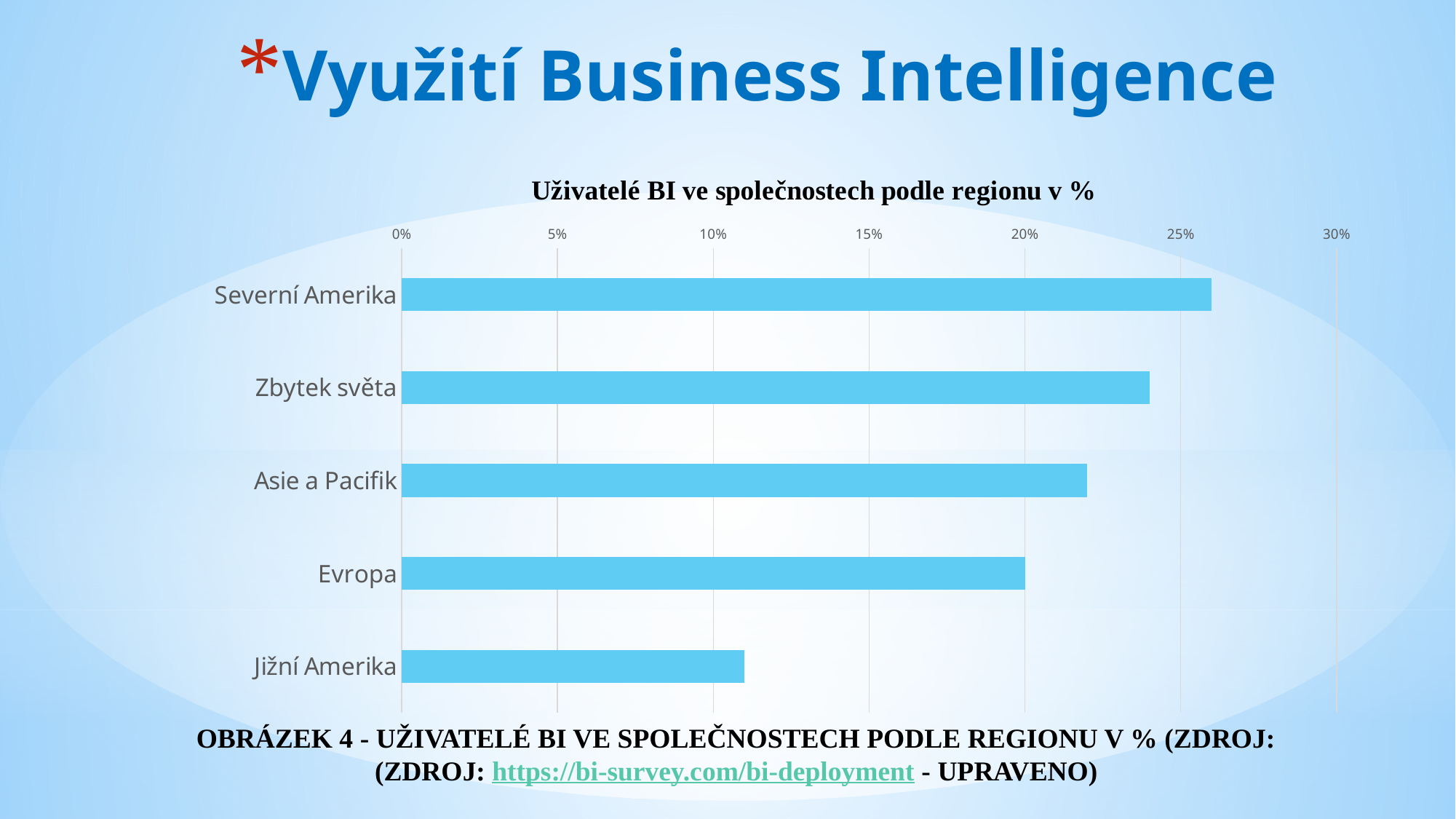
Is the value for Jižní Amerika greater or less than 10%? greater What is the title of the chart? Uživatelé BI ve společnostech podle regionu v % Is the value for Zbytek světa greater or less than 25%? less Which region has the highest share of BI users? Severní Amerika Which region has the lowest share of BI users? Jižní Amerika How many regions are shown in the chart? 5 Do the bar values increase or decrease going from the top region to the bottom region? decrease Which has a larger value, Zbytek světa or Asie a Pacifik? Zbytek světa Is the value for Severní Amerika greater or less than 25%? greater What type of chart is shown on the slide? bar chart Which has a larger value, Evropa or Jižní Amerika? Evropa